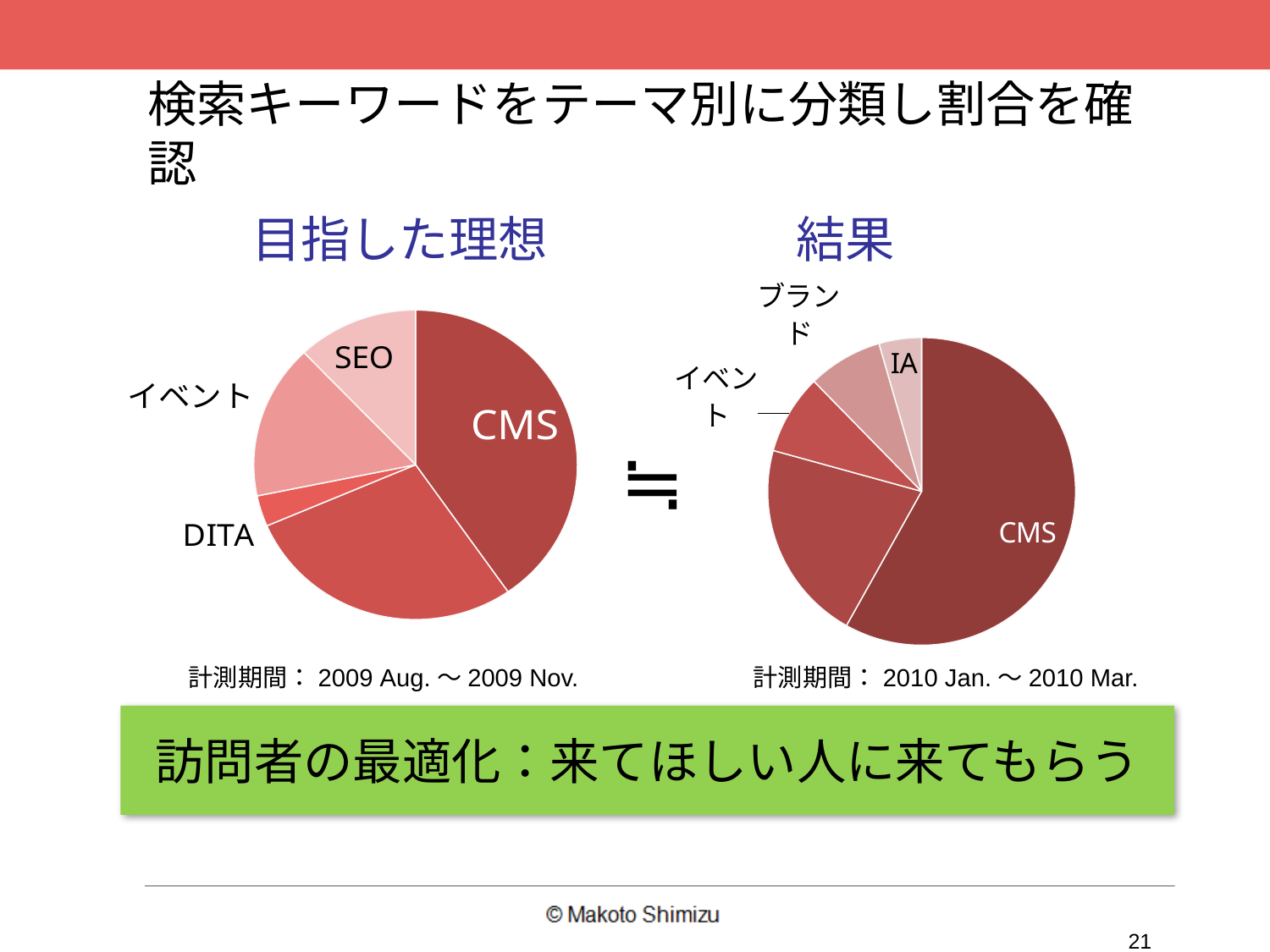
What measurement period is shown under the right chart (結果)? 2010 Jan. ～ 2010 Mar. What measurement period is shown under the left chart (目指した理想)? 2009 Aug. ～ 2009 Nov. How many slices does the left pie chart (目指した理想) have? 5 What kind of chart is the chart titled 結果 on the right? Pie chart How many slices does the right pie chart (結果) have? 5 In the right chart (結果), which slice is larger, CMS or イベント? CMS In the left chart (目指した理想), which labeled category has the smallest slice? DITA In the right chart (結果), which category has the largest slice? CMS In the left chart (目指した理想), which slice is larger, イベント or DITA? イベント In the left chart (目指した理想), which category has the largest slice? CMS In the left chart (目指した理想), which slice is larger, CMS or SEO? CMS What kind of chart is the chart titled 目指した理想 on the left? Pie chart